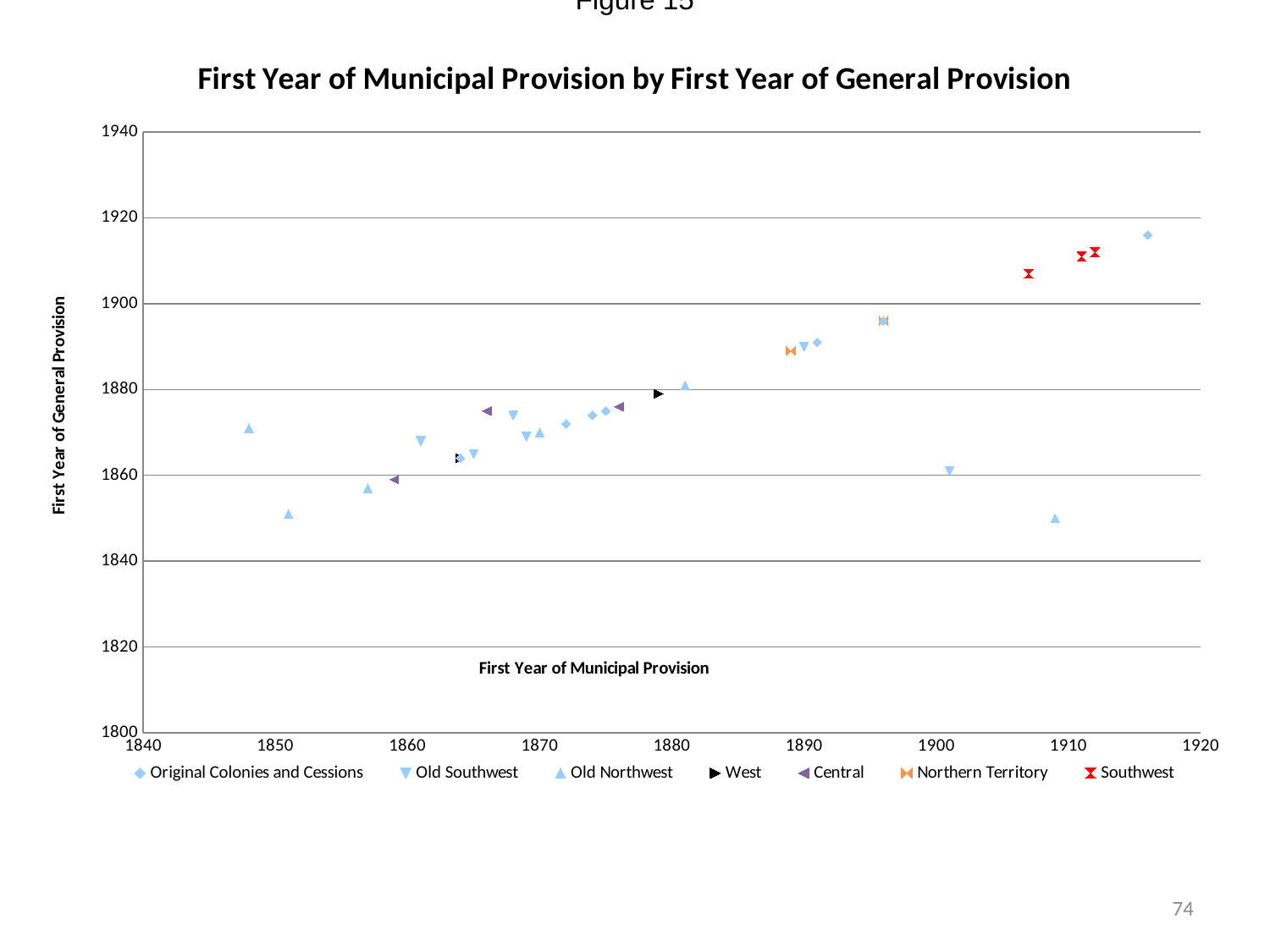
Which series is plotted with red hourglass-shaped markers? Southwest Is the First Year of General Provision for the Old Northwest point plotted near 1848 on the horizontal axis greater or less than 1860? greater How many Southwest points are plotted on the chart? 3 Are the First Year of General Provision values for the Southwest points greater or less than 1900? greater Is the First Year of Municipal Provision for the Southwest points greater or less than 1900? greater What kind of chart is shown on the slide? Scatter chart What is the title of the vertical axis? First Year of General Provision How many series does the legend list? 7 Overall, do the First Year of General Provision values tend to rise or fall as the First Year of Municipal Provision increases? rise What is the title of the chart? First Year of Municipal Provision by First Year of General Provision